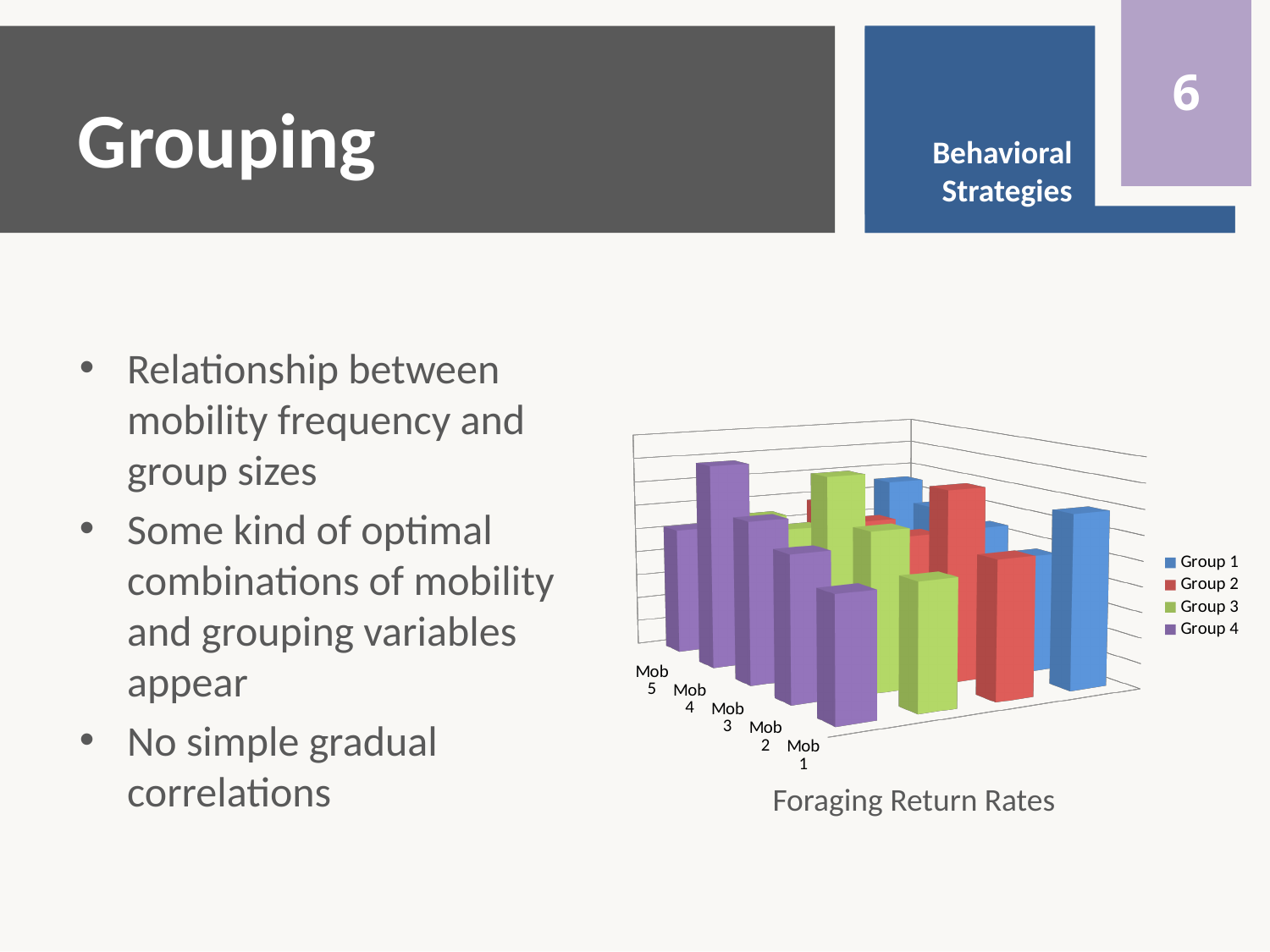
What kind of chart is shown on the slide? bar chart Which series is shown in purple in the chart's legend? Group 4 How many mobility categories (Mob groups) are plotted along the x axis of the chart? 5 For the Group 4 series, which mobility category has the highest bar? Mob 4 How many series does the chart's legend list? 4 What is the title shown beneath the chart? Foraging Return Rates